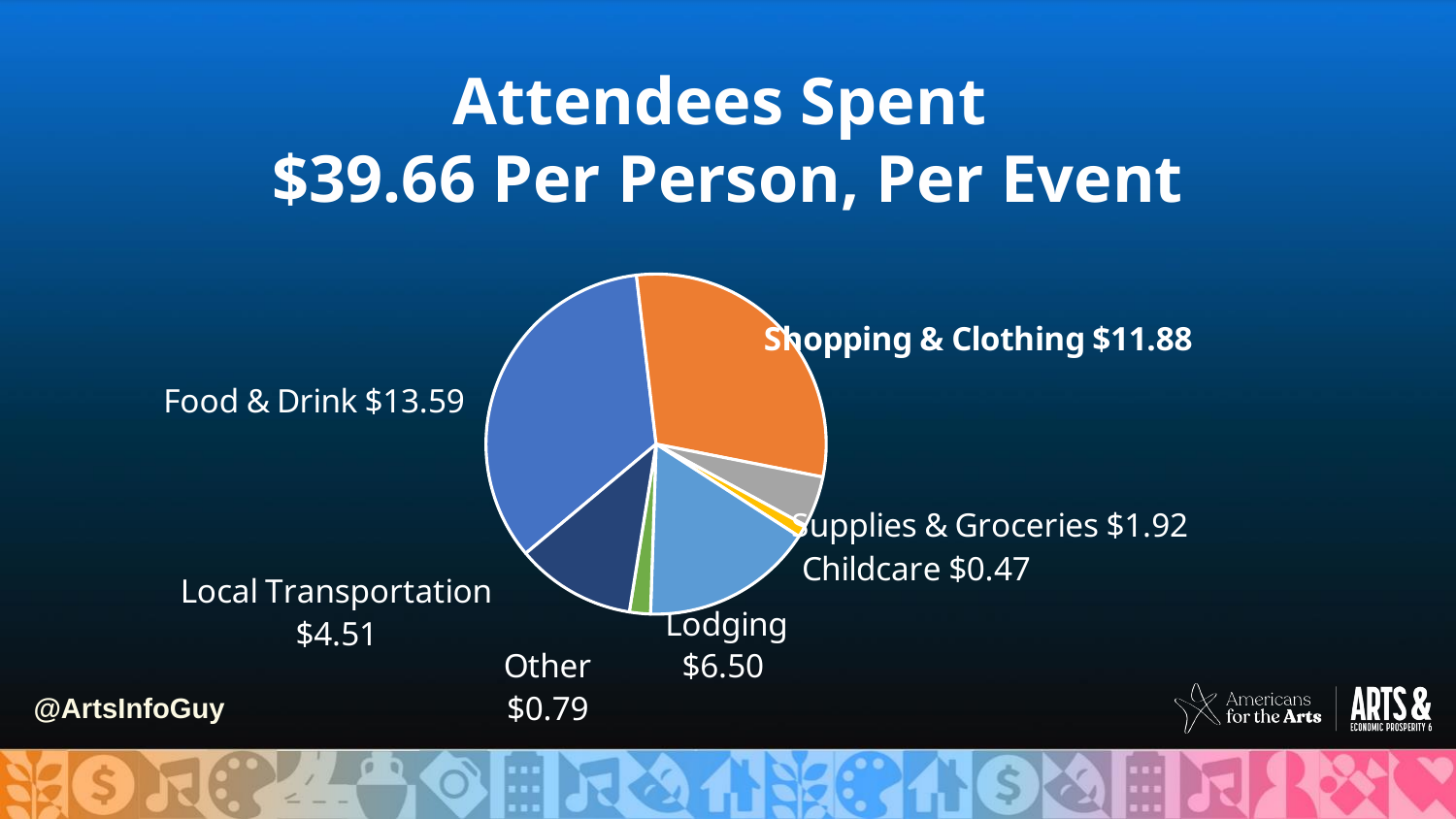
What is the difference between the Supplies & Groceries and Childcare values? $1.45 What kind of chart is shown on the slide? pie chart What is the value shown for Shopping & Clothing? $11.88 How many spending categories are shown in the pie chart? 7 How much did attendees spend on Food & Drink per person, per event? $13.59 Which spending category has the largest slice of the pie? Food & Drink What is the total amount attendees spent per person, per event, according to the slide title? $39.66 What is the value shown for Childcare? $0.47 Which spending category has the smallest slice of the pie? Childcare What is the value shown for Lodging? $6.50 What is the difference between the Food & Drink and Shopping & Clothing values? $1.71 Which is larger, Lodging or Local Transportation? Lodging